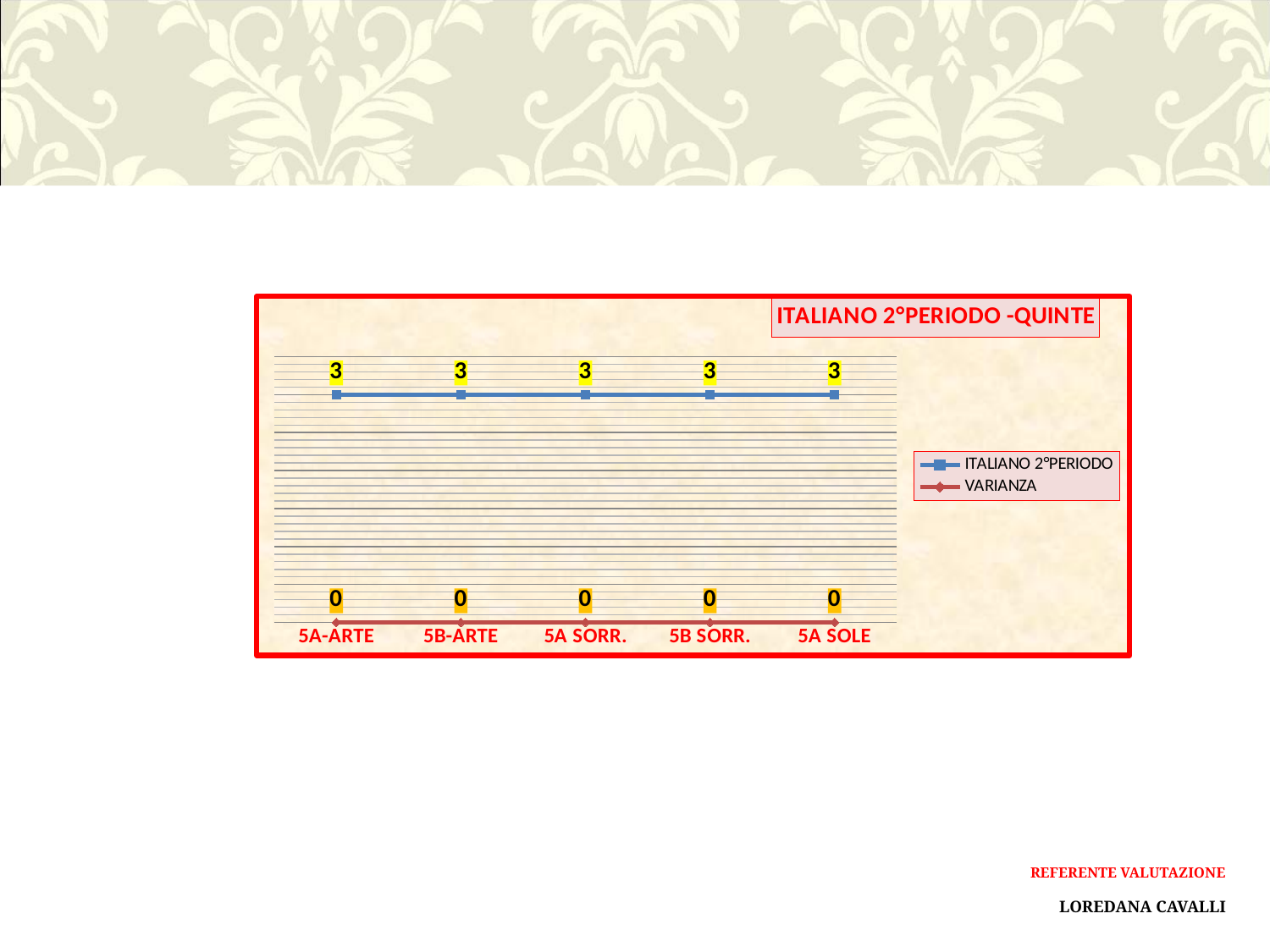
Which series has the larger value for 5B-ARTE, ITALIANO 2°PERIODO or VARIANZA? ITALIANO 2°PERIODO What is the difference between ITALIANO 2°PERIODO and VARIANZA for 5A SORR.? 3 What is the value of VARIANZA for 5B SORR.? 0 What is the value of ITALIANO 2°PERIODO for 5A SOLE? 3 Do the ITALIANO 2°PERIODO values rise, fall or stay flat across the categories? stay flat What kind of chart is shown on the slide? line chart What is the title of the chart? ITALIANO 2°PERIODO -QUINTE What is the value of VARIANZA for 5A-ARTE? 0 How many categories are shown on the x axis? 5 Which series is drawn in blue? ITALIANO 2°PERIODO What is the value of ITALIANO 2°PERIODO for 5A-ARTE? 3 How many series does the legend list? 2